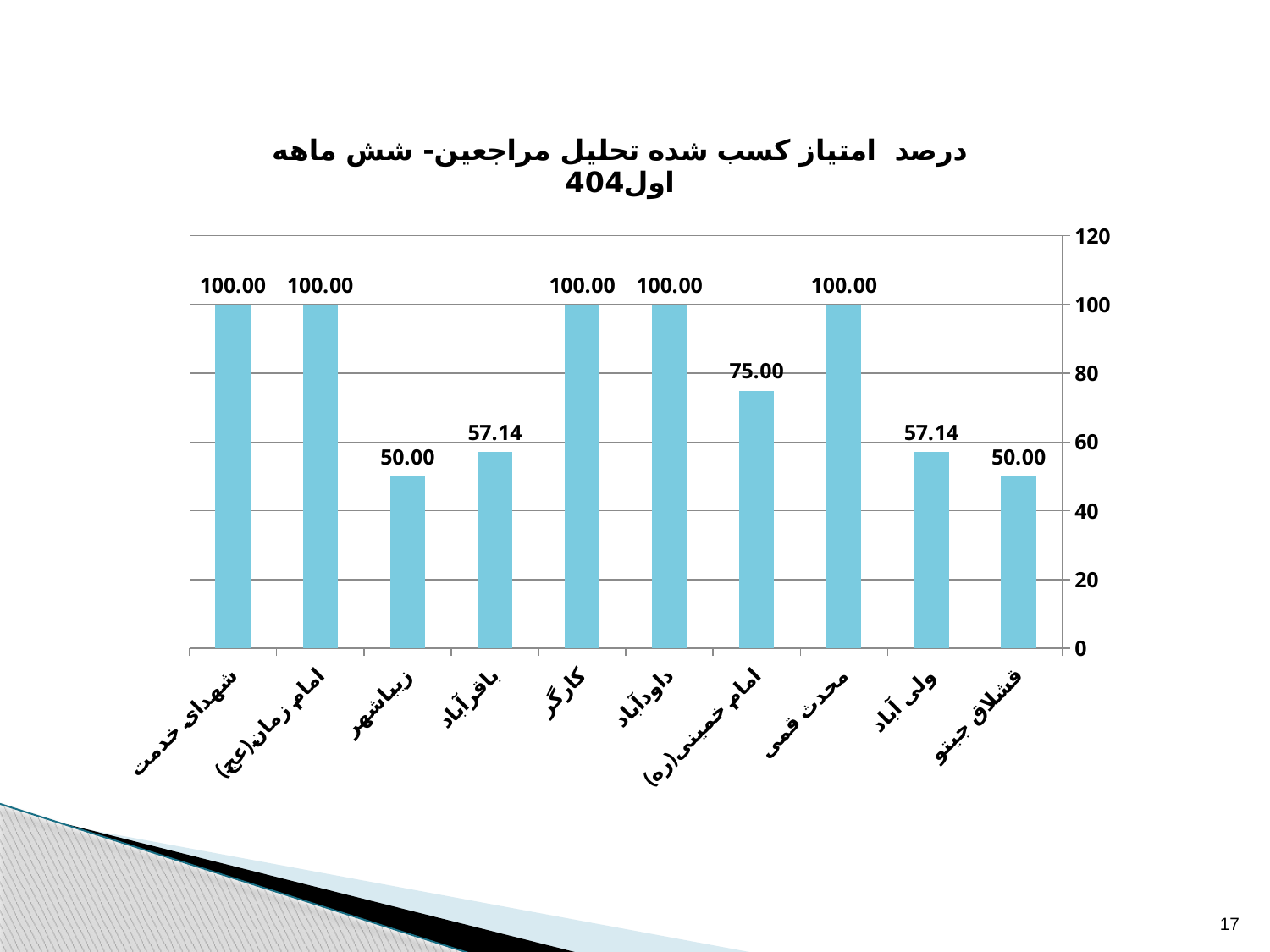
Is the value for امام خمینی(ره) greater or less than 60? greater What kind of chart is shown on the slide? bar chart What is the value for امام خمینی(ره)? 75.00 What is the difference between the values for امام خمینی(ره) and ولی آباد? 17.86 What is the value for باقرآباد? 57.14 What is the value for محدث قمی? 100.00 What is the difference between the values for کارگر and زیباشهر? 50.00 How many categories are shown on the x axis? 10 What is the value for قشلاق جیتو? 50.00 Which is larger, the value for باقرآباد or the value for قشلاق جیتو? باقرآباد What is the value for زیباشهر? 50.00 How many categories have a value of 100.00? 5